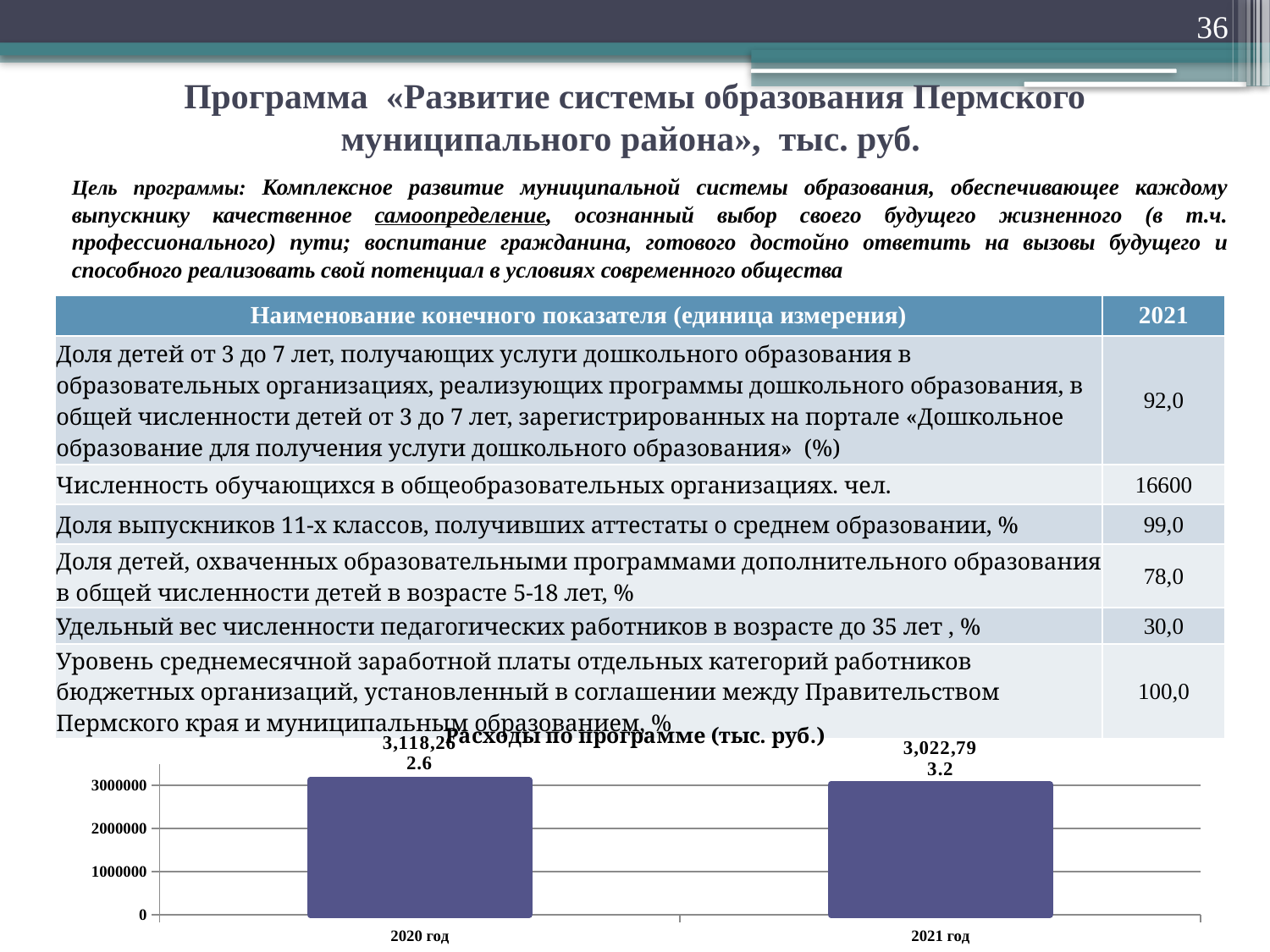
How many bars (categories) does the chart «Расходы по программе (тыс. руб.)» show? 2 In the chart «Расходы по программе (тыс. руб.)», which year has the higher value? 2020 год In the chart «Расходы по программе (тыс. руб.)», do the values rise or fall from 2020 год to 2021 год? fall What is the highest tick value shown on the vertical axis of the chart «Расходы по программе (тыс. руб.)»? 3000000 What is the title of the bar chart at the bottom of the slide? Расходы по программе (тыс. руб.) What is the data label shown on the bar for 2021 год in the chart «Расходы по программе (тыс. руб.)»? 3,022,793.2 In the chart «Расходы по программе (тыс. руб.)», is the value for 2021 год greater or less than 2000000? greater What kind of chart is shown at the bottom of the slide under the title «Расходы по программе (тыс. руб.)»? bar chart In the chart «Расходы по программе (тыс. руб.)», is the value for 2020 год larger or smaller than the value for 2021 год? larger In the chart «Расходы по программе (тыс. руб.)», is the value for 2020 год greater or less than 3000000? greater In the chart «Расходы по программе (тыс. руб.)», which year has the lower value? 2021 год What is the data label shown on the bar for 2020 год in the chart «Расходы по программе (тыс. руб.)»? 3,118,262.6